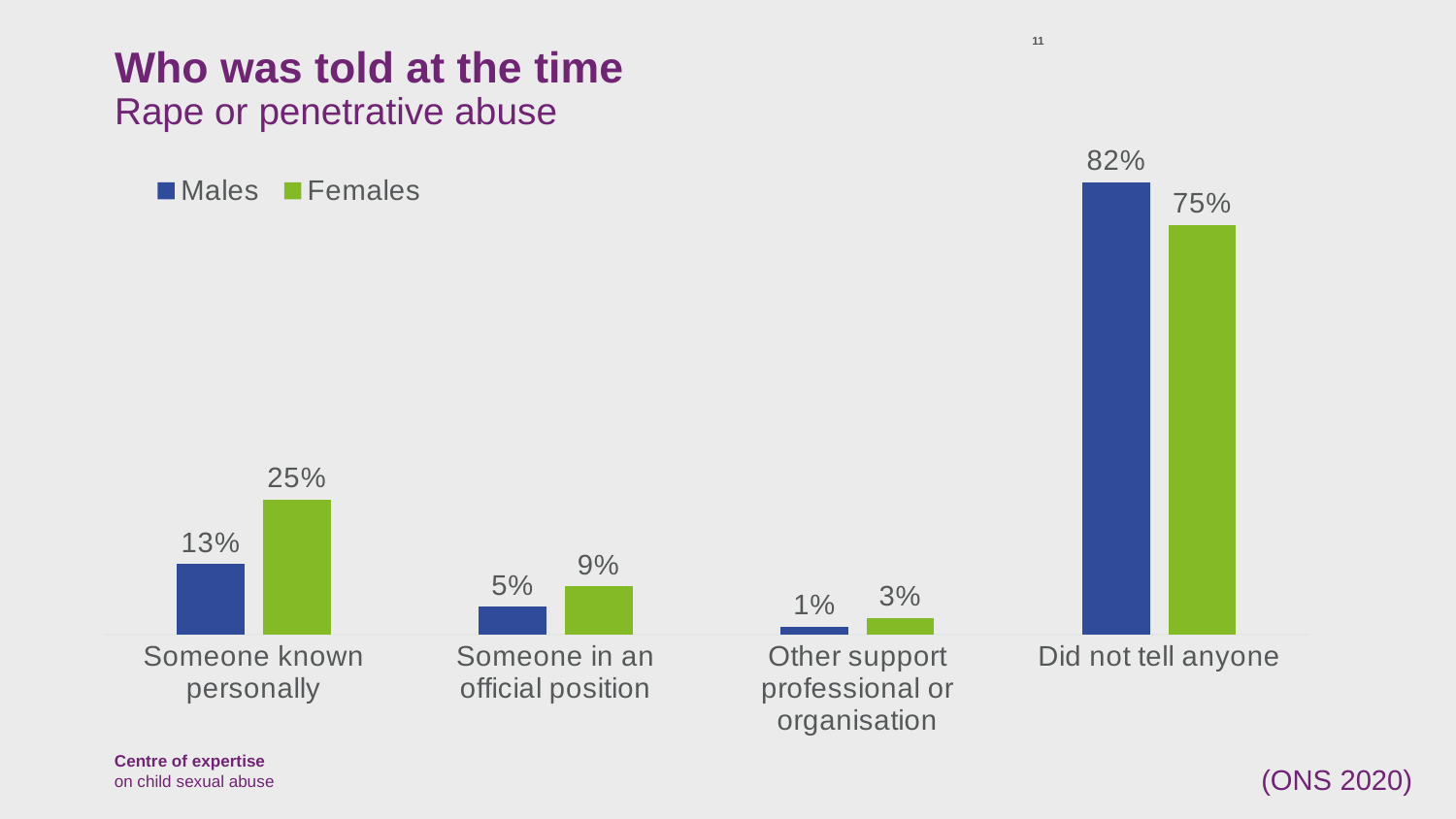
For 'Someone in an official position', which is larger: the value for males or for females? Females What type of chart is shown on the slide? Bar chart What is the value for females for 'Someone in an official position'? 9% Which category has the highest value for males? Did not tell anyone What is the difference between the male and female values for 'Did not tell anyone'? 7% Which category has the lowest value for females? Other support professional or organisation What is the difference between the female and male values for 'Someone known personally'? 12% How many categories are shown on the x axis? 4 What is the value for males for 'Other support professional or organisation'? 1% What percentage of females did not tell anyone? 75% How many series does the legend list? 2 What percentage of males told someone known personally? 13%